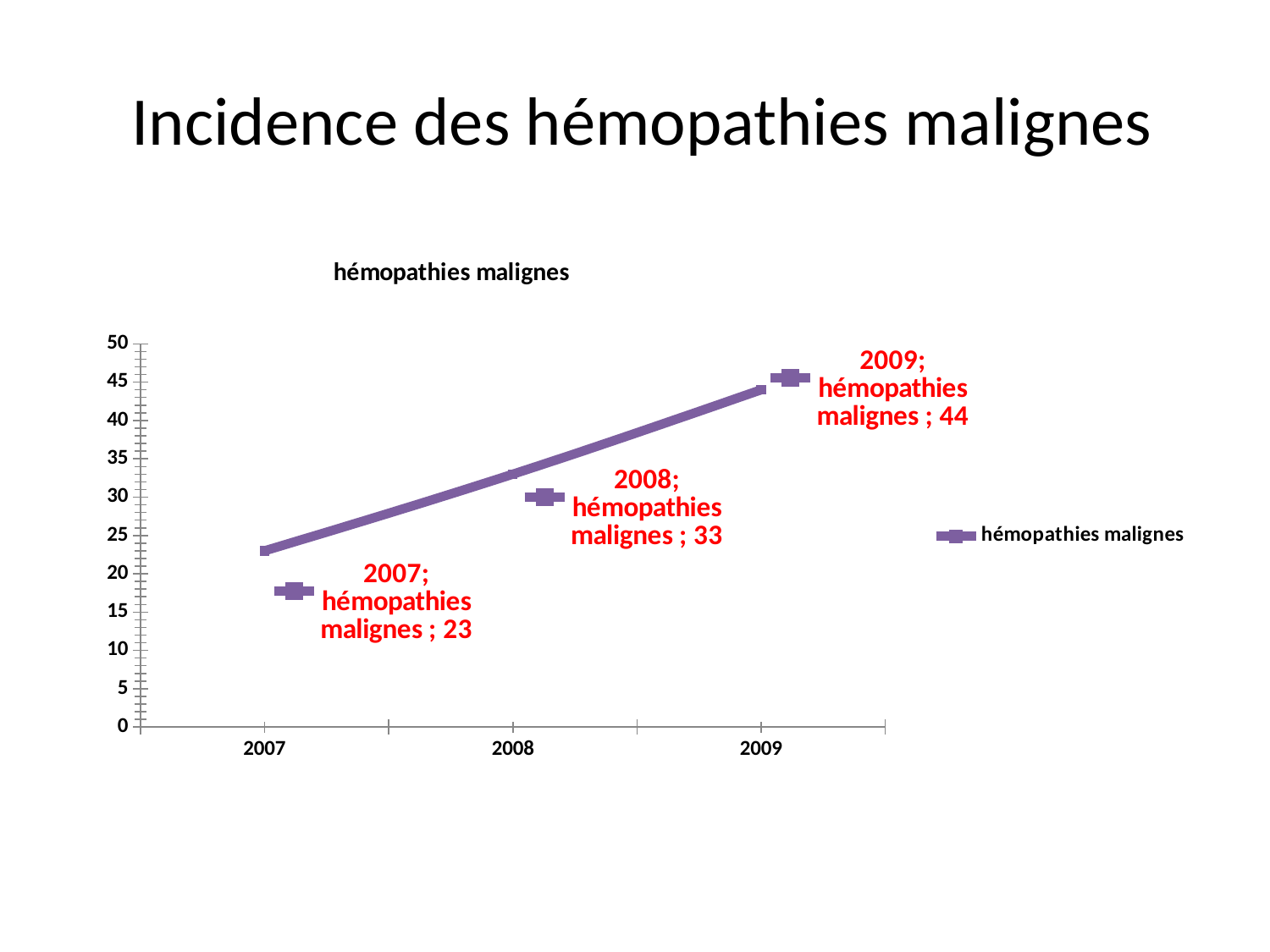
How many years are plotted on the chart? 3 Which is larger, the value for 2008 or the value for 2009? 2009 What is the value for hémopathies malignes in 2009? 44 What is the difference between the 2009 and 2007 values for hémopathies malignes? 21 Is the value for 2009 greater or less than 40? greater What is the value for hémopathies malignes in 2008? 33 Which year has the highest value for hémopathies malignes? 2009 What kind of chart is shown on the slide? line chart What is the value for hémopathies malignes in 2007? 23 What is the difference between the 2008 and 2007 values for hémopathies malignes? 10 Which year has the lowest value for hémopathies malignes? 2007 Do the values rise or fall from 2007 to 2009? rise